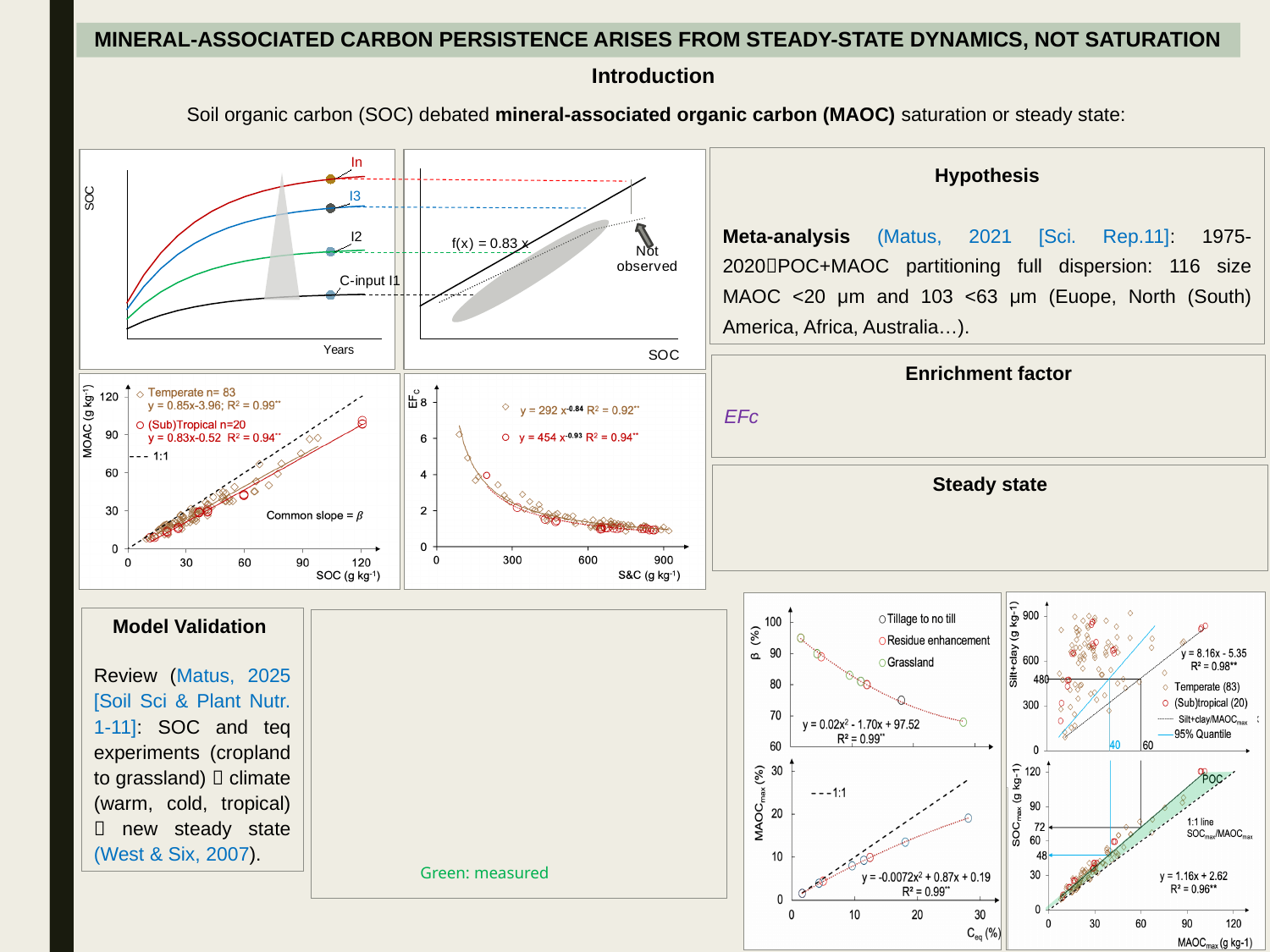
In the chart of MAOC (g kg-1) versus SOC (g kg-1), what kind of chart is it? scatter chart In the chart of β (%) versus Ceq (%), do the β values rise or fall as Ceq increases? fall In the chart of MAOC (g kg-1) versus SOC (g kg-1), which series has the larger sample size, Temperate or (Sub)Tropical? Temperate In the chart of Silt+clay (g kg-1) versus MAOCmax, what is the R² value printed for the equation y = 8.16x - 5.35? 0.98** In the chart of MAOC (g kg-1) versus SOC (g kg-1), what is the sample size n for the (Sub)Tropical series? 20 In the chart of MAOC (g kg-1) versus SOC (g kg-1), what is the sample size n for the Temperate series? 83 In the top-left chart of SOC versus Years, how many curves are plotted? 4 In the chart of EFc versus S&C (g kg-1), do the EFc values rise or fall as S&C increases? fall In the chart of MAOC (g kg-1) versus SOC (g kg-1), how many data series does the legend list besides the 1:1 line? 2 In the chart of EFc versus S&C (g kg-1), what is the R² value printed for the equation y = 454 x^-0.93? 0.94** In the chart of β (%) versus Ceq (%), how many series does the legend list? 3 In the chart of MAOC (g kg-1) versus SOC (g kg-1), what is the R² value printed for the Temperate regression? 0.99**